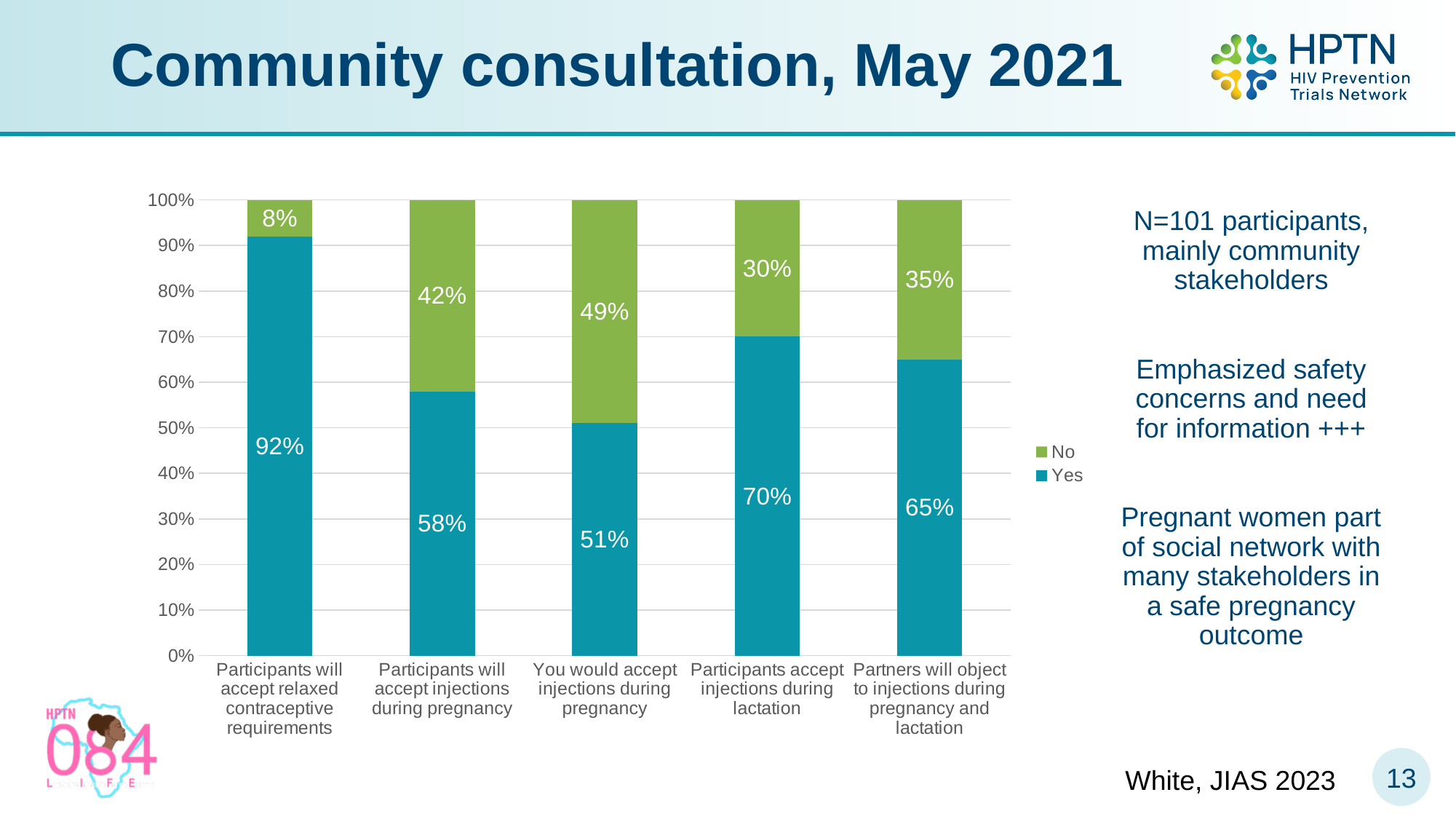
What percentage answered Yes to "Participants will accept relaxed contraceptive requirements"? 92% What is the difference between the Yes values for "Participants accept injections during lactation" and "Participants will accept injections during pregnancy"? 12% Which category has the highest Yes percentage? Participants will accept relaxed contraceptive requirements What is the Yes value for "Participants accept injections during lactation"? 70% What percentage answered No to "You would accept injections during pregnancy"? 49% Which colour represents the Yes series in the chart? Teal (blue) How many series does the legend list? 2 Which is larger: the No value for "Participants will accept injections during pregnancy" or the No value for "Participants accept injections during lactation"? Participants will accept injections during pregnancy What is the No value for "Partners will object to injections during pregnancy and lactation"? 35% How many categories are shown on the x axis? 5 Which category has the lowest Yes percentage? You would accept injections during pregnancy What kind of chart is shown on the slide? Stacked bar chart